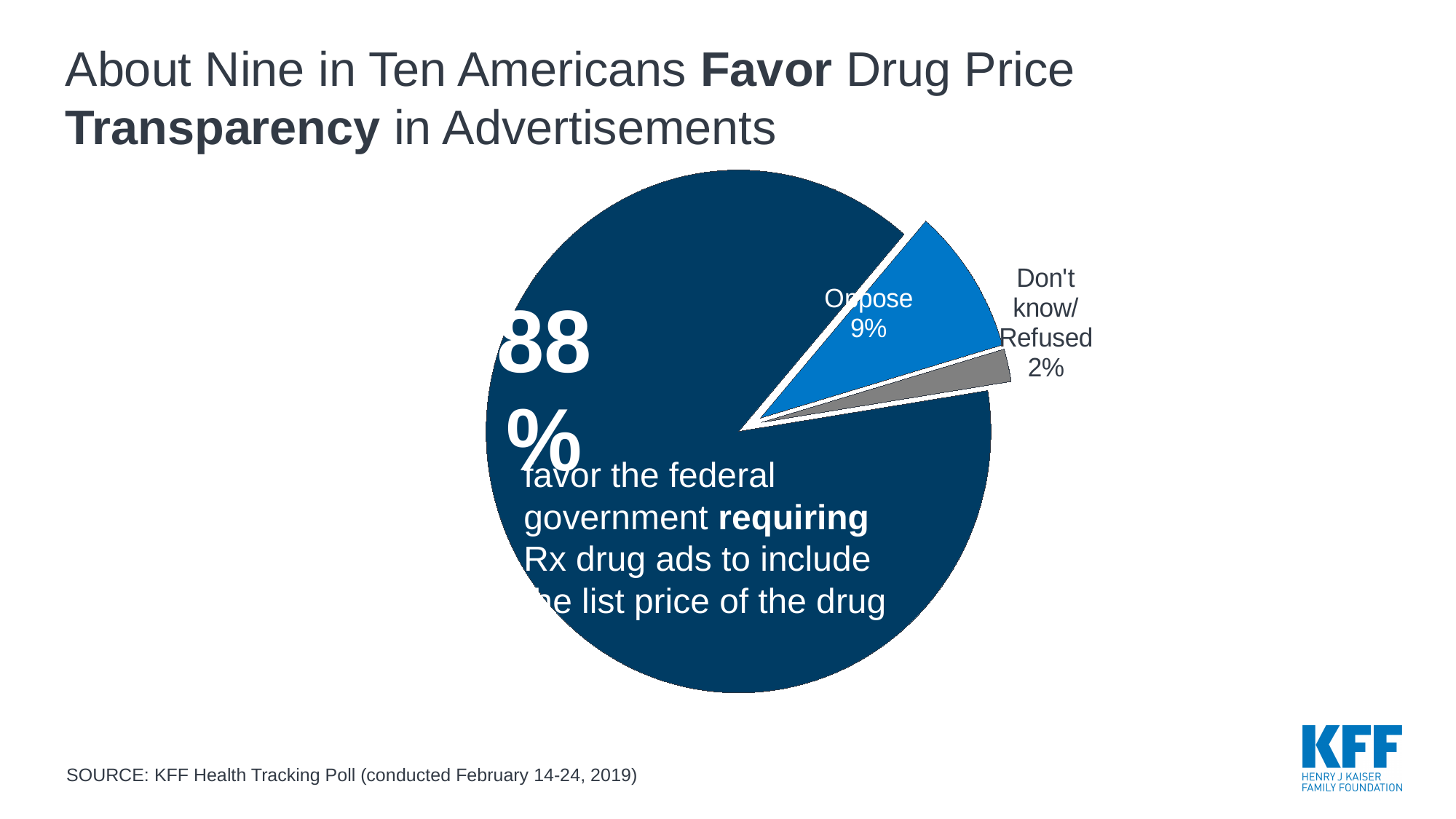
What kind of chart is shown on the slide? Pie chart What percentage favor the federal government requiring Rx drug ads to include the list price of the drug? 88% How many slices does the pie chart have? 3 Which response has the largest share of the pie? Favor What is the difference in percentage points between those who oppose and those who don't know/refused? 7 Which response has the smallest share of the pie? Don't know/Refused What percentage is shown for Don't know/Refused? 2% What colour is the Oppose slice? Blue Which is larger, the Oppose share or the Don't know/Refused share? Oppose What is the difference in percentage points between those who favor and those who oppose? 79 What percentage of Americans oppose requiring Rx drug ads to include the list price? 9% What is the source of the data shown in the chart? KFF Health Tracking Poll (conducted February 14-24, 2019)